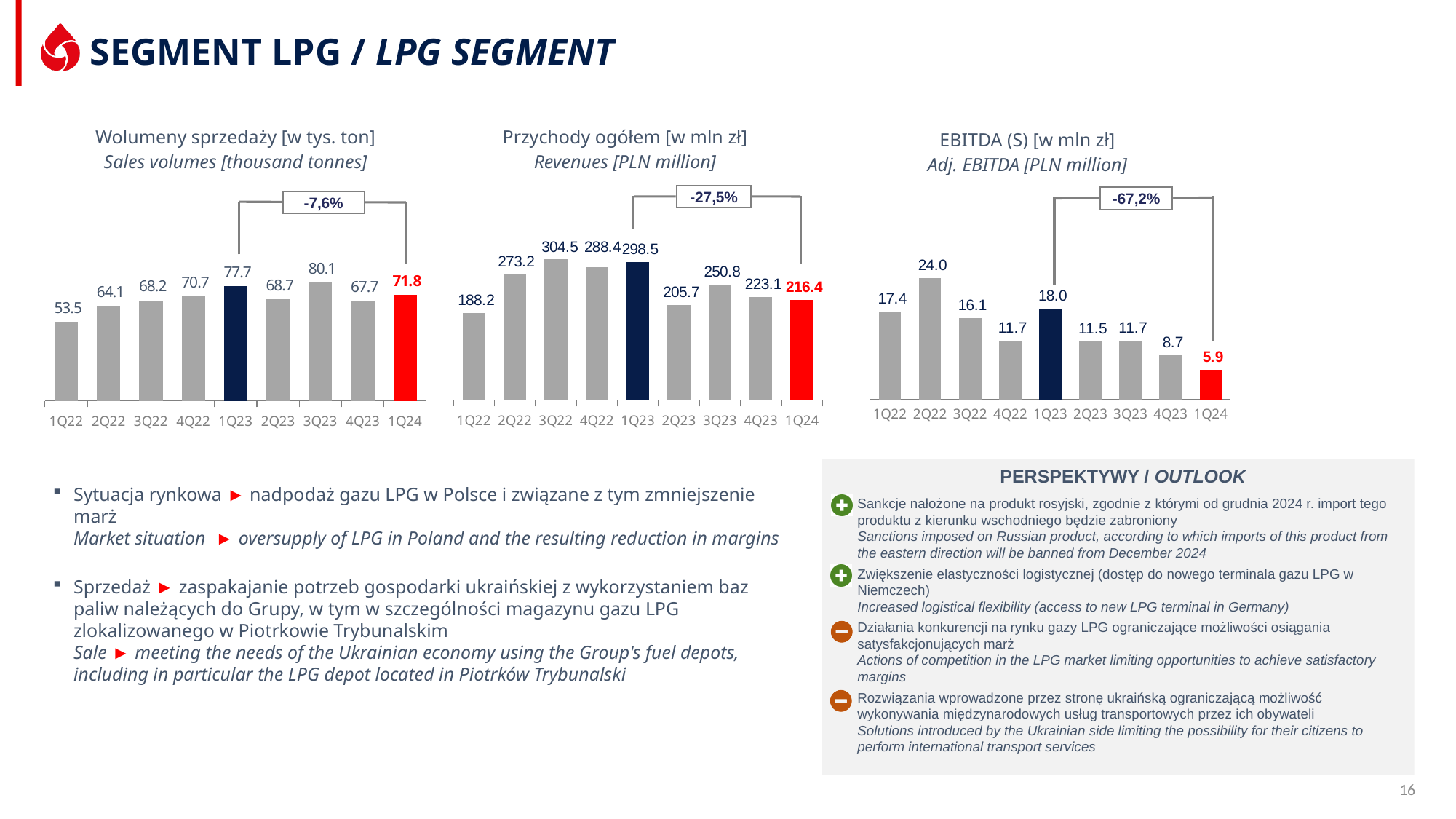
What percentage change is shown above the Sales volumes chart between 1Q23 and 1Q24? -7,6% How many quarters are shown on the x axis of the Revenues chart? 9 In the Revenues chart, what is the difference between 1Q23 and 1Q24? 82.1 In the Sales volumes chart, which quarter has the lowest value? 1Q22 In the Adj. EBITDA chart, what is the value for 2Q22? 24.0 In the Adj. EBITDA chart, is the value for 1Q23 or 4Q23 larger? 1Q23 In the Sales volumes chart, which quarter has the highest value? 3Q23 In the Sales volumes chart, what is the value for 1Q24? 71.8 In the Revenues chart, what is the value for 3Q22? 304.5 In the Adj. EBITDA chart, which quarter has the lowest value? 1Q24 In the Revenues chart, which quarter has the lowest value? 1Q22 What type of chart is the Adj. EBITDA chart? Bar chart